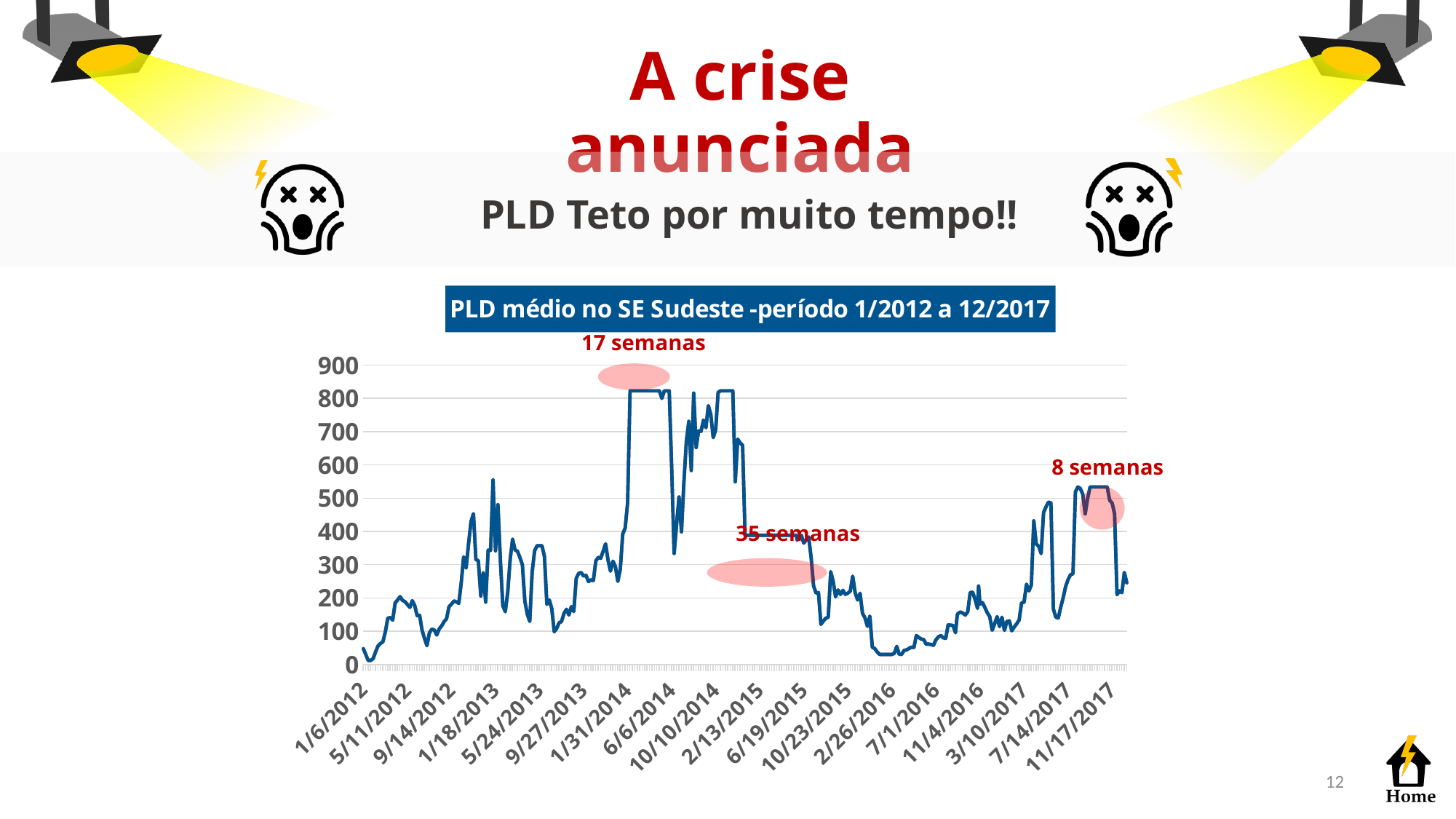
Is the value around 7/14/2017 greater or less than 400? less How many date labels are shown along the x axis of the chart? 18 Is the value at 1/6/2012 greater or less than 100? less What is the title of the chart? PLD médio no SE Sudeste -período 1/2012 a 12/2017 Does the line generally rise or fall between 1/31/2014 and 2/26/2016? Fall In which year does the line reach its highest values? 2014 What kind of chart is shown on the slide? Line chart Is the value around 2/26/2016 greater or less than 100? less What is the highest value shown on the y axis of the chart? 900 Does the line generally rise or fall between 2/26/2016 and 7/14/2017? Rise